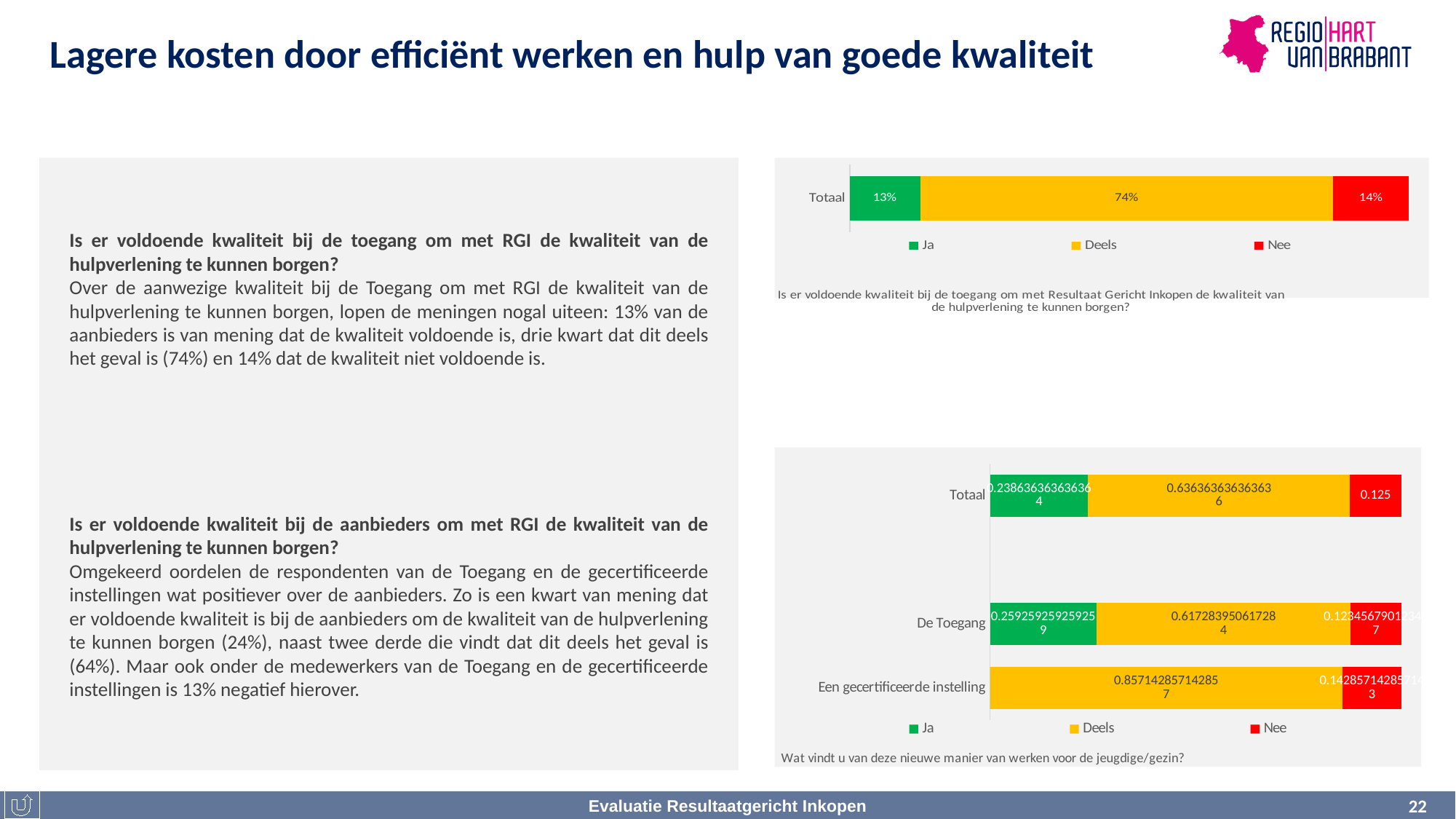
In the top chart, what is the value for Ja in the Totaal bar? 13% In the top chart, what is the difference between the Deels and Nee values in the Totaal bar? 60% In the top chart, how many series does the legend list? 3 What kind of chart is the bottom chart? Stacked bar chart In the top chart, what is the value for Nee in the Totaal bar? 14% In the bottom chart, what is the Nee value for Totaal? 0.125 In the bottom chart, what is the Deels value for Een gecertificeerde instelling? 0.857142857142857 In the top chart, which series has the largest share of the Totaal bar? Deels In the bottom chart, which category has the largest Deels value? Een gecertificeerde instelling In the bottom chart, how many categories are shown on the vertical axis? 3 In the top chart, what is the value for Deels in the Totaal bar? 74% In the bottom chart, which colour represents the Nee series? Red